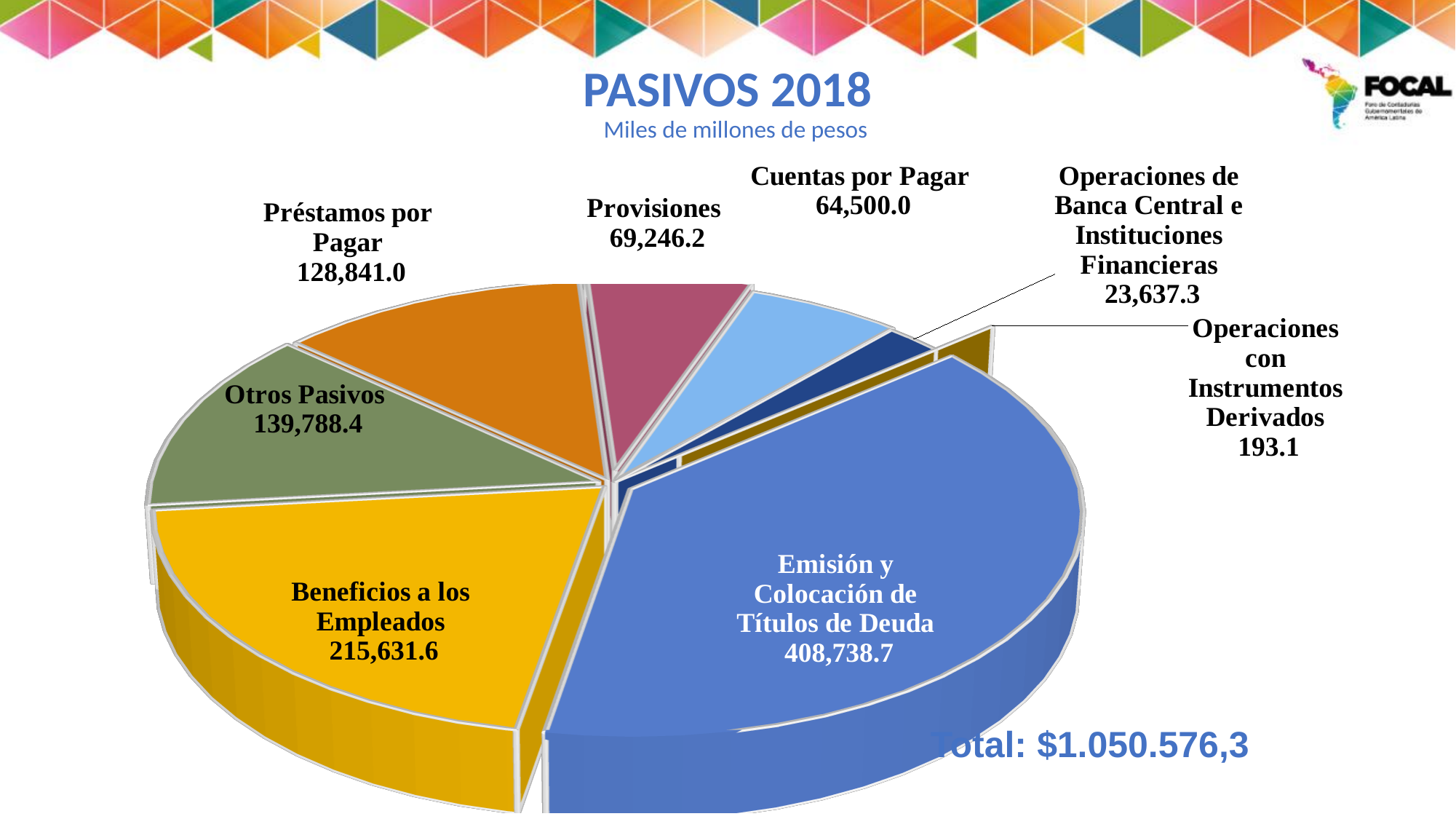
What is the value for Beneficios a los Empleados? 215,631.6 Which category has the smallest slice of the pie? Operaciones con Instrumentos Derivados What unit is stated in the chart's subtitle? Miles de millones de pesos What kind of chart is shown on the slide? Pie chart Which is larger, Otros Pasivos or Préstamos por Pagar? Otros Pasivos How many categories are shown in the pie chart? 8 What share of the total does Emisión y Colocación de Títulos de Deuda represent? 38.9% What is the difference between Beneficios a los Empleados and Otros Pasivos? 75,843.2 What is the value for Operaciones de Banca Central e Instituciones Financieras? 23,637.3 Which category has the largest slice of the pie? Emisión y Colocación de Títulos de Deuda What is the value for Provisiones? 69,246.2 What is the difference between Provisiones and Cuentas por Pagar? 4,746.2